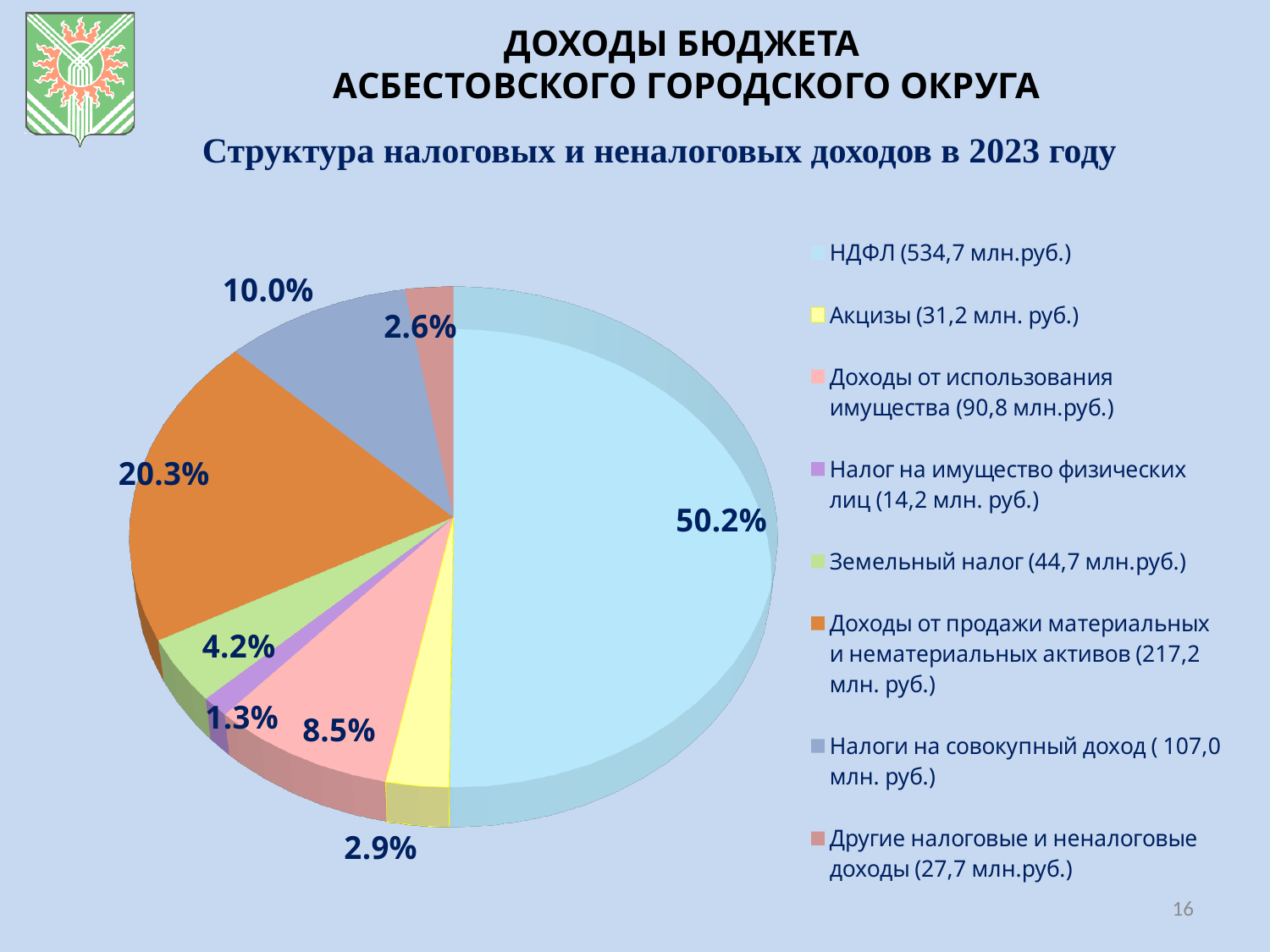
What share of the pie does НДФЛ account for? 50.2% What share of the pie does Земельный налог account for? 4.2% How many slices does the pie chart have? 8 What is the difference in percentage points between the НДФЛ share and the Доходы от продажи материальных и нематериальных активов share? 29.9 Which is larger: the share for Акцизы or the share for Другие налоговые и неналоговые доходы? Акцизы Which category has the smallest slice of the pie? Налог на имущество физических лиц Which category has the largest slice of the pie? НДФЛ What kind of chart is shown on the slide? pie chart What is the value for Акцизы shown in the legend? 31,2 млн. руб. What share of the pie does Налоги на совокупный доход account for? 10.0% What is the value for Доходы от использования имущества shown in the legend? 90,8 млн.руб.